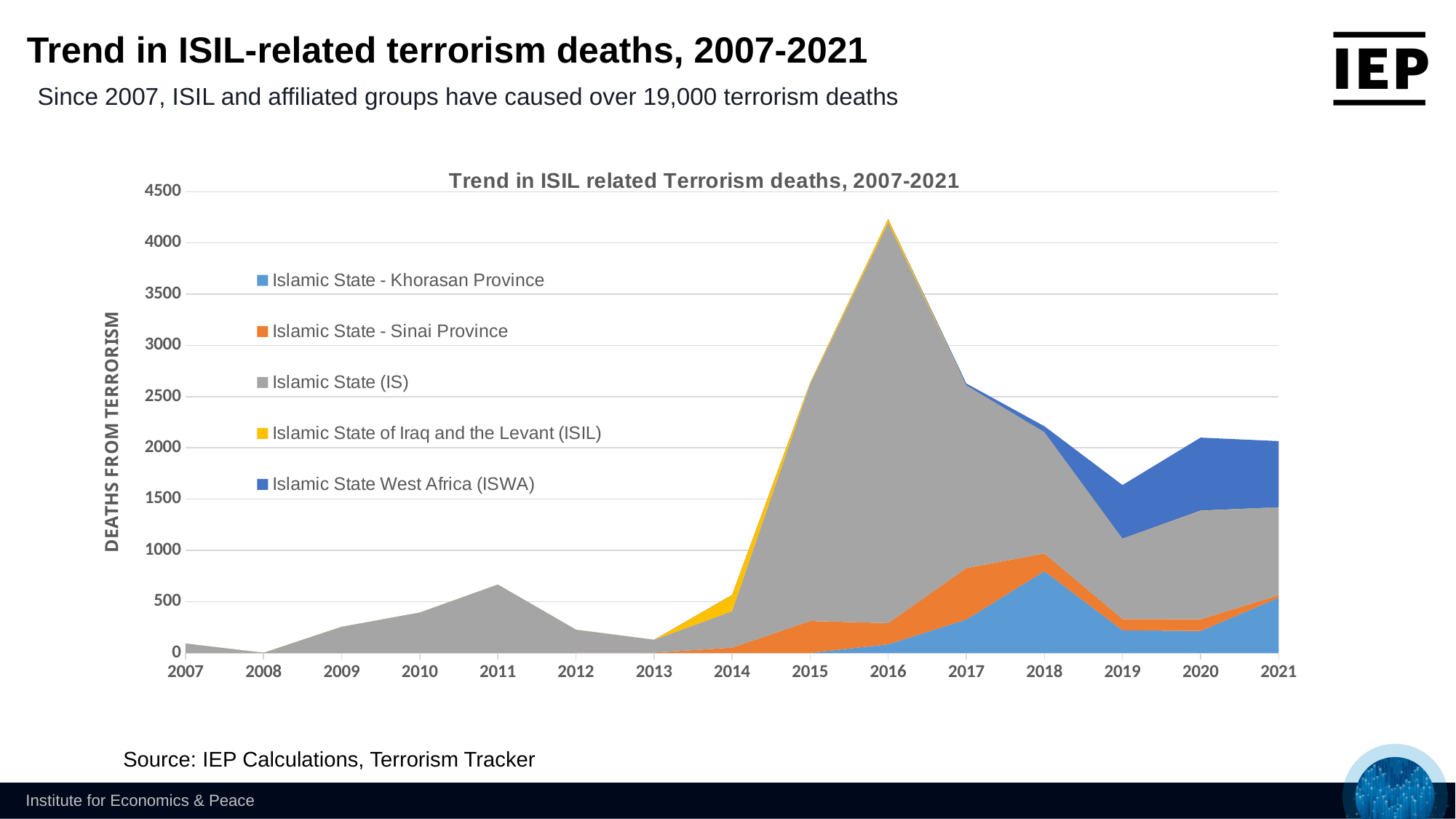
Is the total number of deaths in 2014 greater or less than 1000? less Do total deaths rise or fall from 2016 to 2019? Fall Is the total number of deaths in 2011 greater or less than 1000? less What kind of chart is shown on the slide? Stacked area chart Which year has a higher total of deaths, 2011 or 2016? 2016 In which year is the total number of deaths lowest? 2008 What is the label on the y axis? DEATHS FROM TERRORISM In which year does the total number of ISIL-related terrorism deaths peak? 2016 How many series does the legend list? 5 Is the total number of deaths in 2016 greater or less than 4000? greater How many years are shown along the x axis? 15 Which series accounts for the largest share of deaths in 2016? Islamic State (IS)